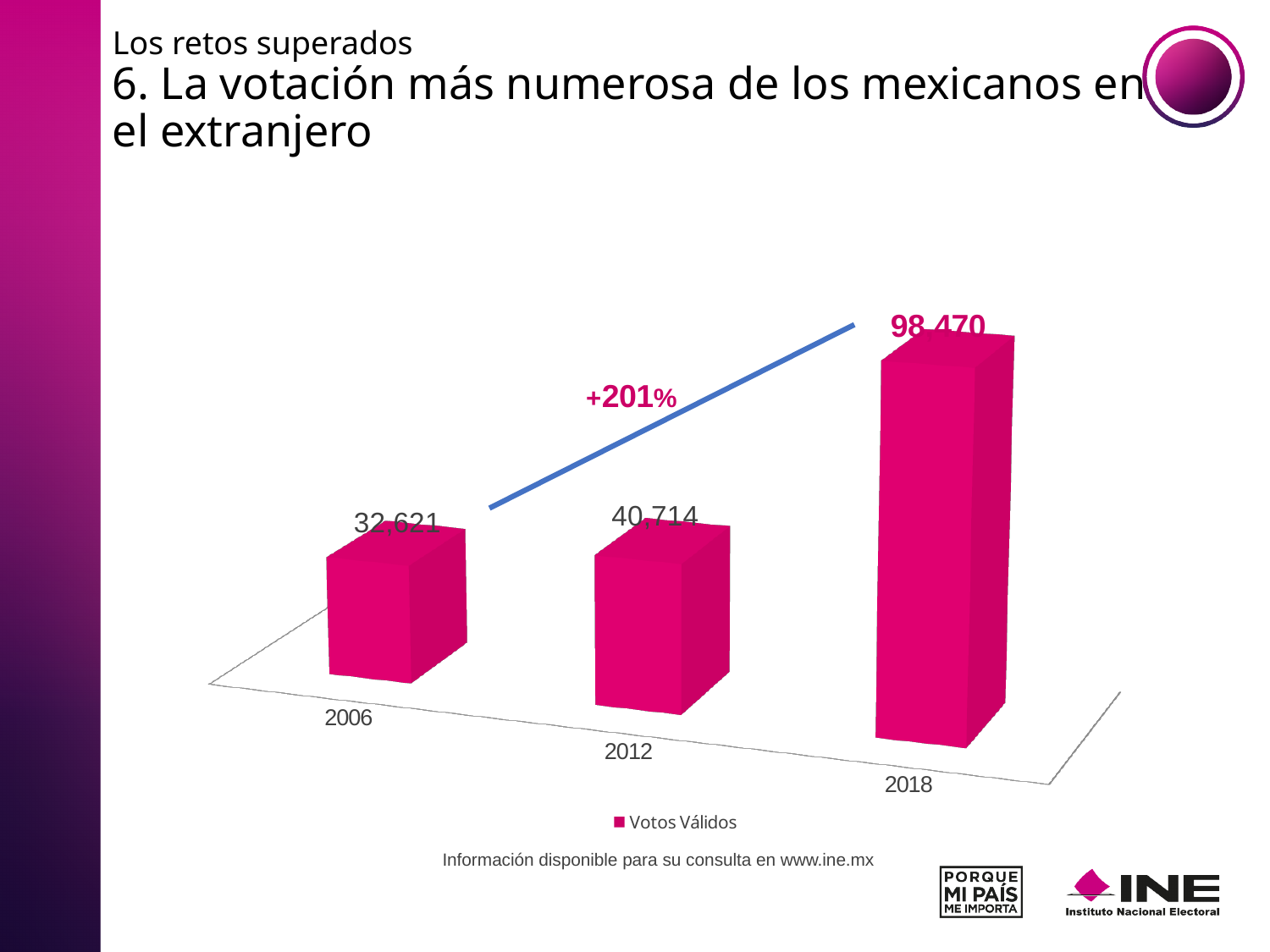
Which year has the highest value? 2018 What is the value for 2006? 32,621 What kind of chart is shown on the slide? Bar chart How many series does the legend list? 1 What is the difference between the values for 2018 and 2012? 57,756 Which is larger, the value for 2012 or the value for 2006? 2012 Which year has the lowest value? 2006 How many years are shown on the chart? 3 What is the difference between the values for 2012 and 2006? 8,093 Do the values rise or fall from 2006 to 2018? Rise What is the value for 2012? 40,714 What is the value for 2018? 98,470